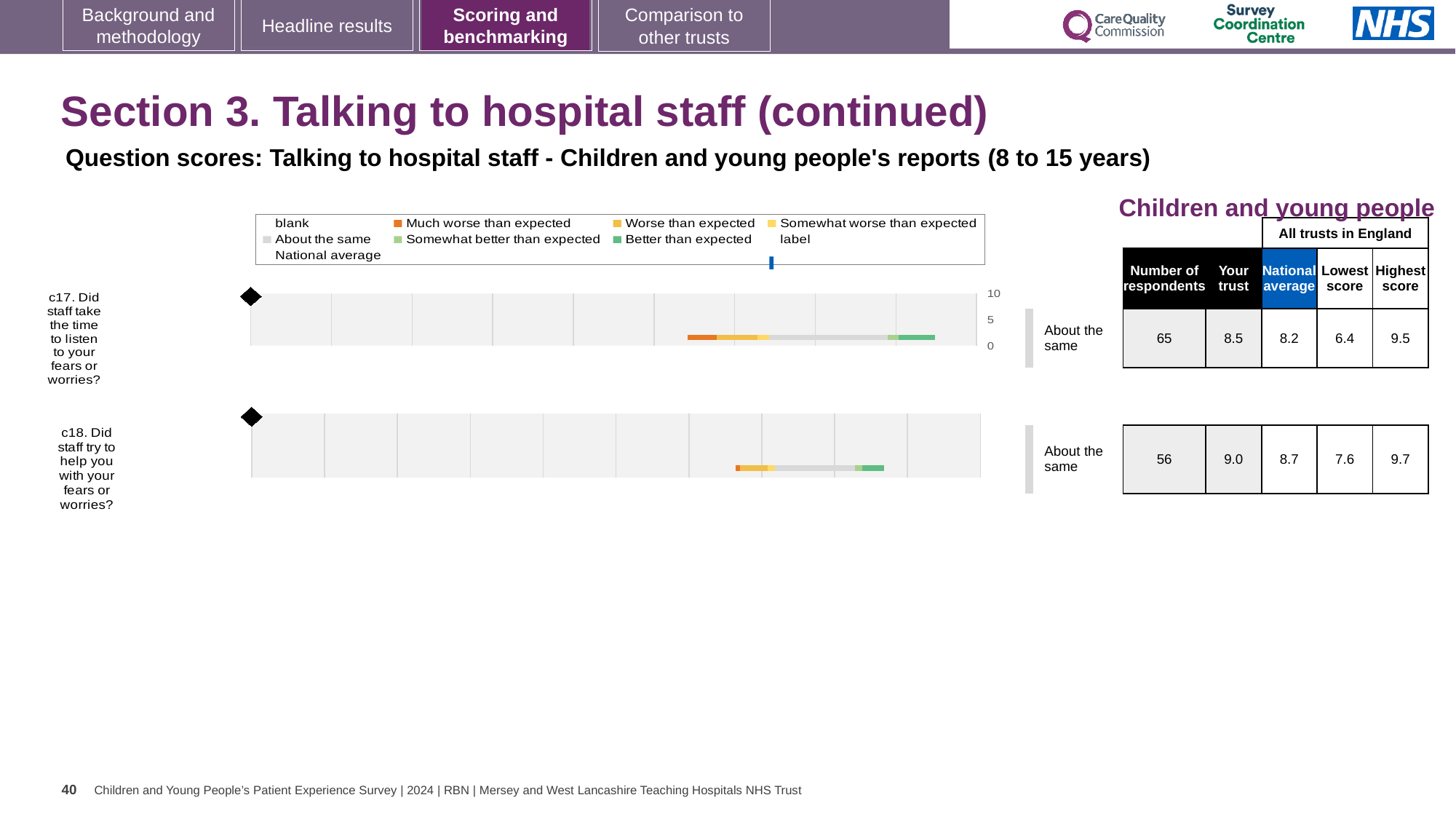
What kind of chart is used to show the benchmarking results for c17 and c18? bar chart What is the 'Your trust' score for c17 (Did staff take the time to listen to your fears or worries?)? 8.5 What is the lowest score across all trusts in England for c18? 7.6 For c17, which is larger: the 'Your trust' score or the national average? Your trust For c17, how much higher is the 'Your trust' score than the national average? 0.3 How many respondents answered c17? 65 Which of the two questions has the higher 'Your trust' score? c18 What benchmarking category is the trust's result for c18 placed in? About the same For c18, what is the difference between the highest score and the lowest score across all trusts in England? 2.1 What is the national average score for c18 (Did staff try to help you with your fears or worries?)? 8.7 How many survey questions are plotted on the slide? 2 What is the highest score across all trusts in England for c17? 9.5